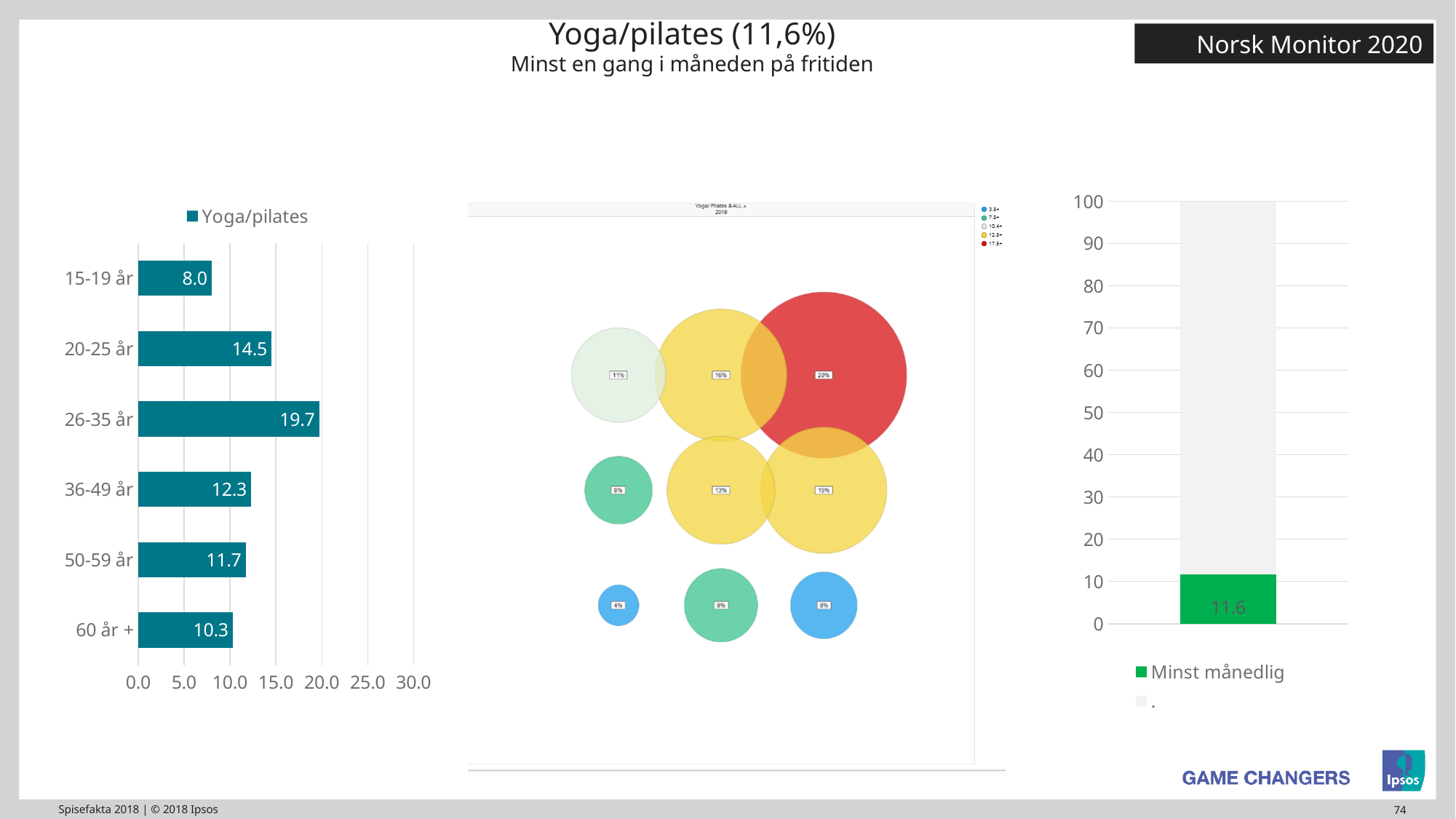
What kind of chart is the left chart on the slide? Bar chart In the left bar chart, what is the value for 15-19 år? 8.0 In the left bar chart, what is the difference between the values for 20-25 år and 36-49 år? 2.2 In the left bar chart, which age group has the lowest value? 15-19 år How many age groups are shown in the left bar chart? 6 In the right chart, is the value for Minst månedlig greater or less than 20? less In the right chart, what is the value shown for Minst månedlig? 11.6 In the left bar chart, which age group has the highest value? 26-35 år In the left bar chart, what is the value for 26-35 år? 19.7 In the left bar chart, which is larger, the value for 50-59 år or the value for 60 år +? 50-59 år What series name does the legend of the left bar chart show? Yoga/pilates In the left bar chart, what is the value for 60 år +? 10.3